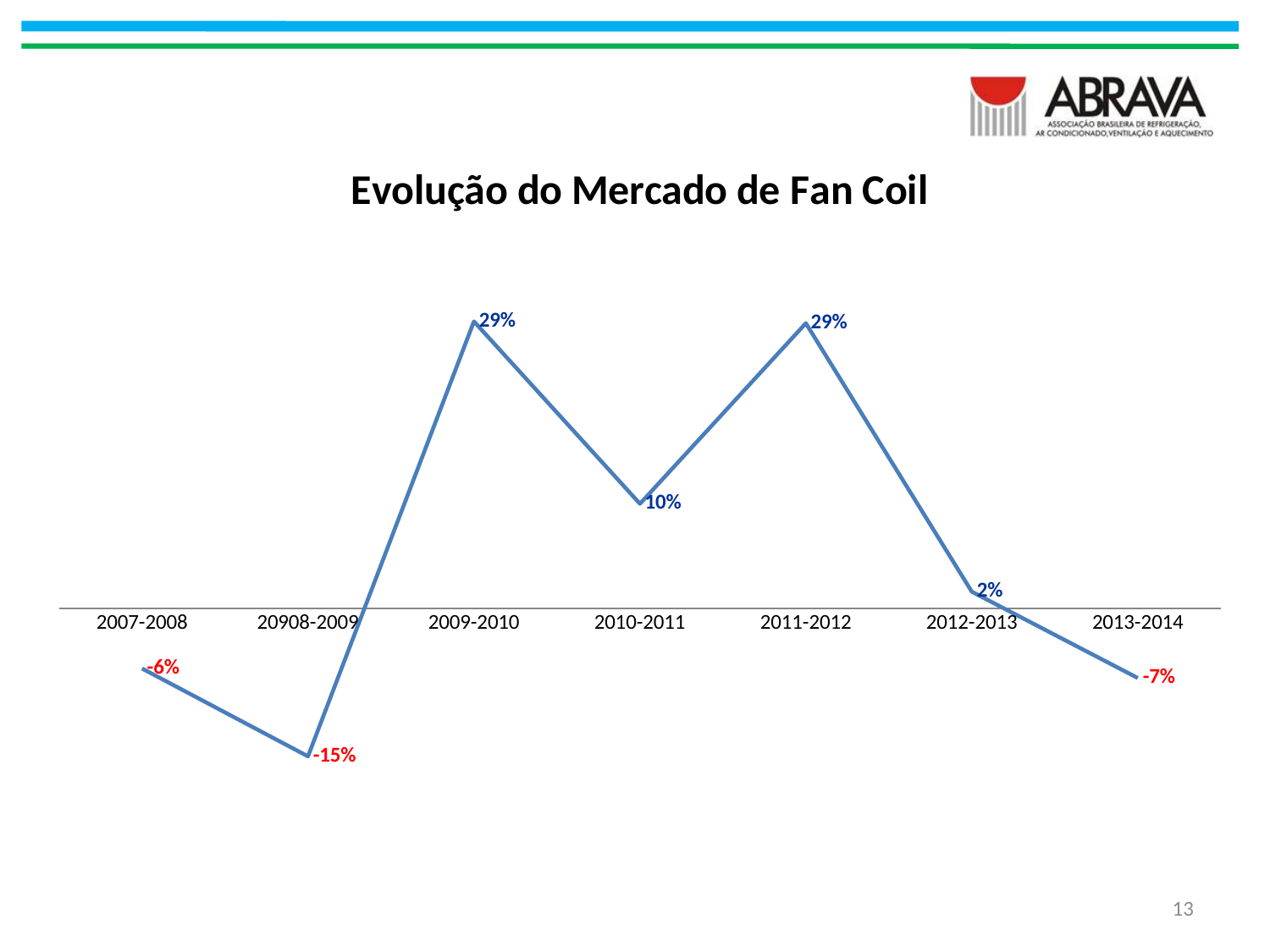
What is the value for 2010-2011? 10% What is the value for 2009-2010? 29% Which period has the lowest value? 20908-2009 What is the value for 2007-2008? -6% What is the difference between the values for 2011-2012 and 2012-2013? 27% Which is larger, the value for 2010-2011 or the value for 2012-2013? 2010-2011 What is the value for 2012-2013? 2% What kind of chart is shown on the slide? line chart What is the title of the chart? Evolução do Mercado de Fan Coil What is the value for 2013-2014? -7% How many data points are plotted on the line? 7 What is the highest value shown on the chart? 29%